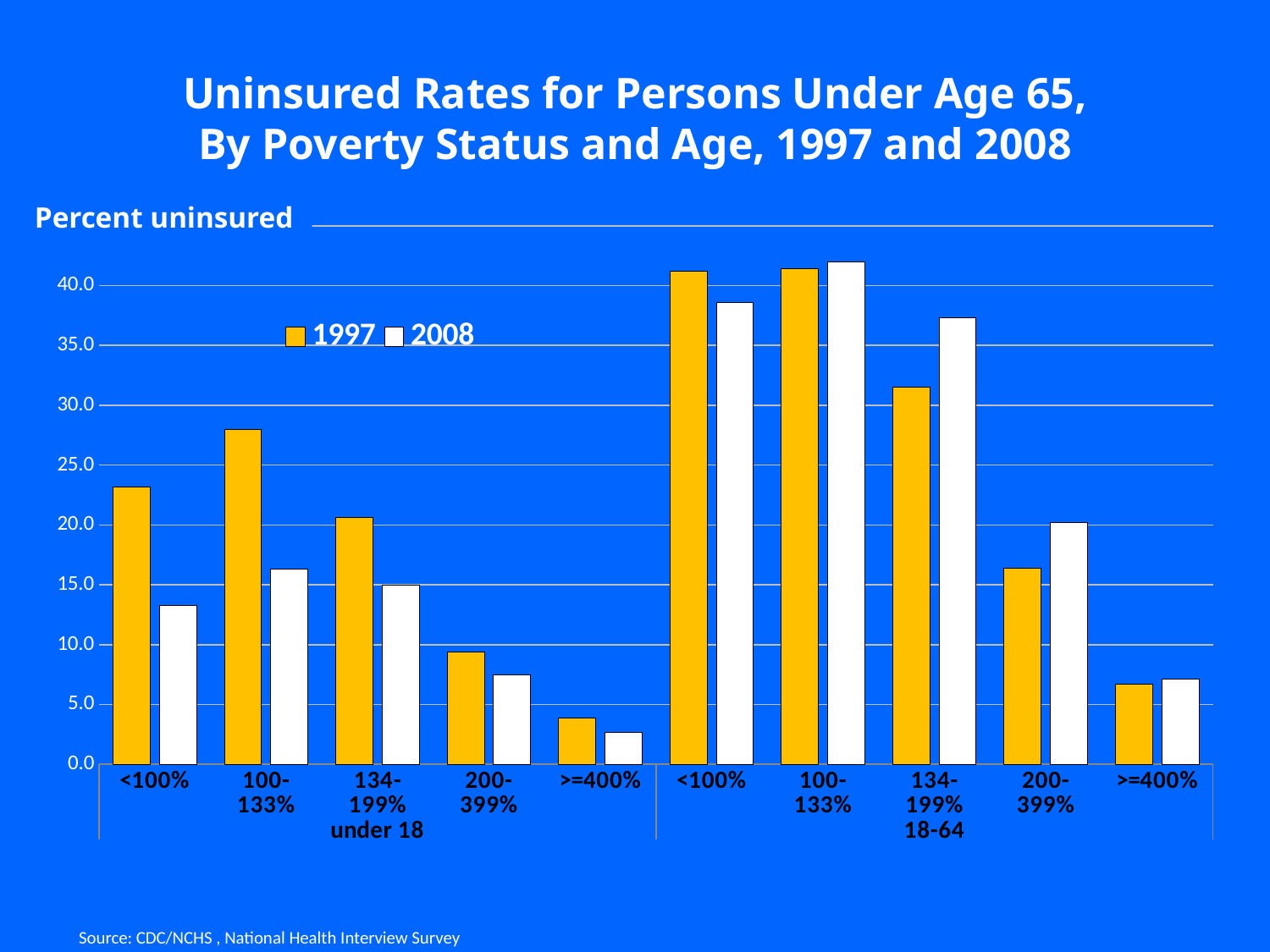
For 100-133% in the under 18 group, which year has the higher uninsured rate, 1997 or 2008? 1997 How many poverty status categories are shown for the under 18 age group? 5 What kind of chart is shown on the slide? bar chart Is the 2008 value for 134-199% in the 18-64 group greater or less than 35.0? greater How many series does the legend list? 2 Is the 2008 value for <100% in the under 18 group greater or less than 15.0? less For 134-199% in the 18-64 group, which year has the higher uninsured rate, 1997 or 2008? 2008 Is the 1997 value for <100% in the under 18 group greater or less than 20.0? greater Which poverty status category has the highest 1997 uninsured rate in the under 18 group? 100-133% Which bar is the lowest on the whole chart? 2008, >=400%, under 18 What colour represents the 2008 series in the legend? white